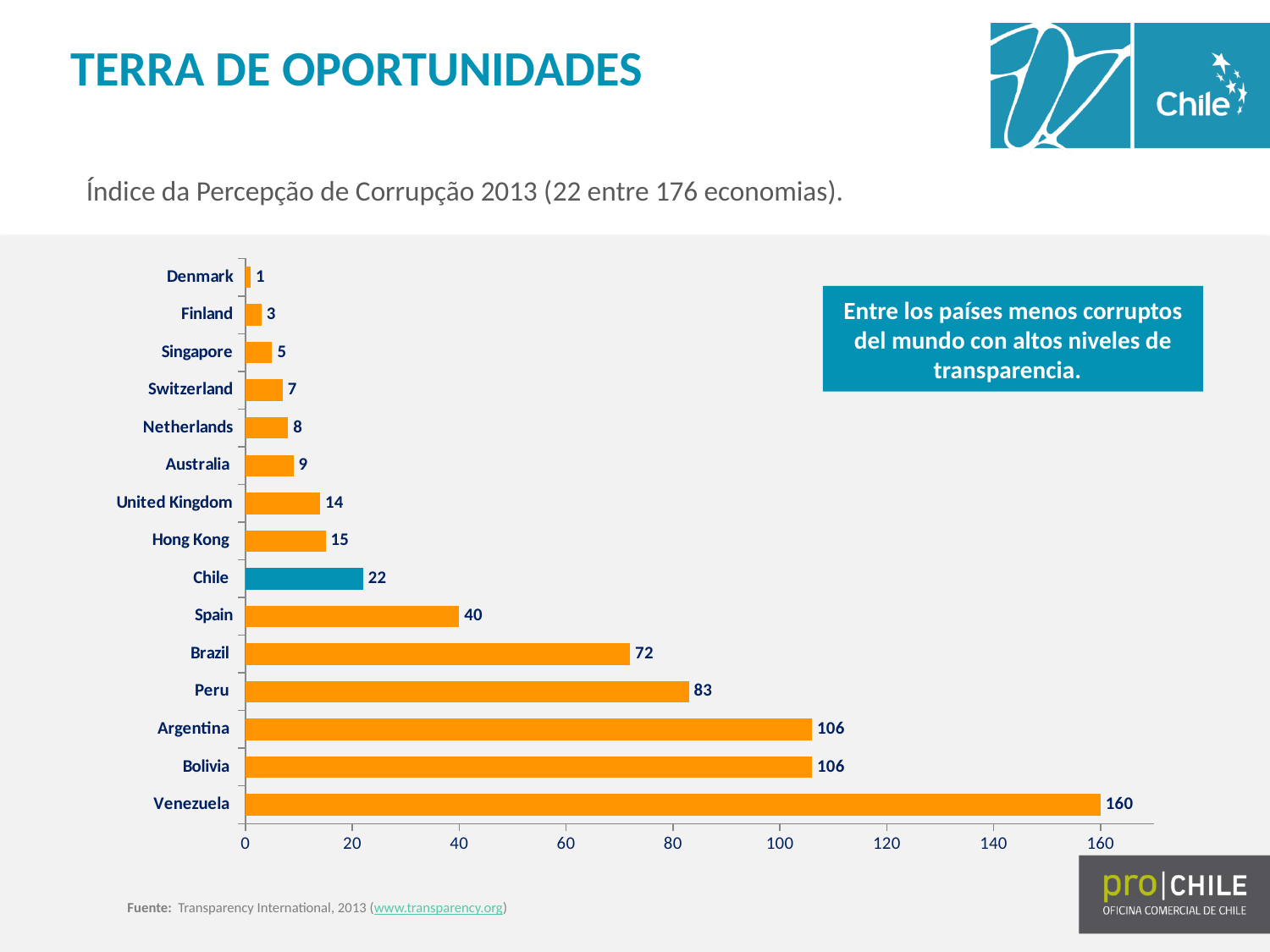
Which has a larger value, Spain or Hong Kong? Spain Which country has the highest value on the chart? Venezuela What is the value shown for Brazil? 72 What is the difference between the values for Peru and Chile? 61 Which country has the lowest value on the chart? Denmark Which two countries share the same value of 106? Argentina and Bolivia What is the difference between the values for Venezuela and Argentina? 54 Which country's bar is shown in a different colour (blue) from the others? Chile What kind of chart is shown on the slide? Bar chart How many countries are shown on the chart? 15 What is the value shown for Denmark? 1 What is the value shown for Chile? 22